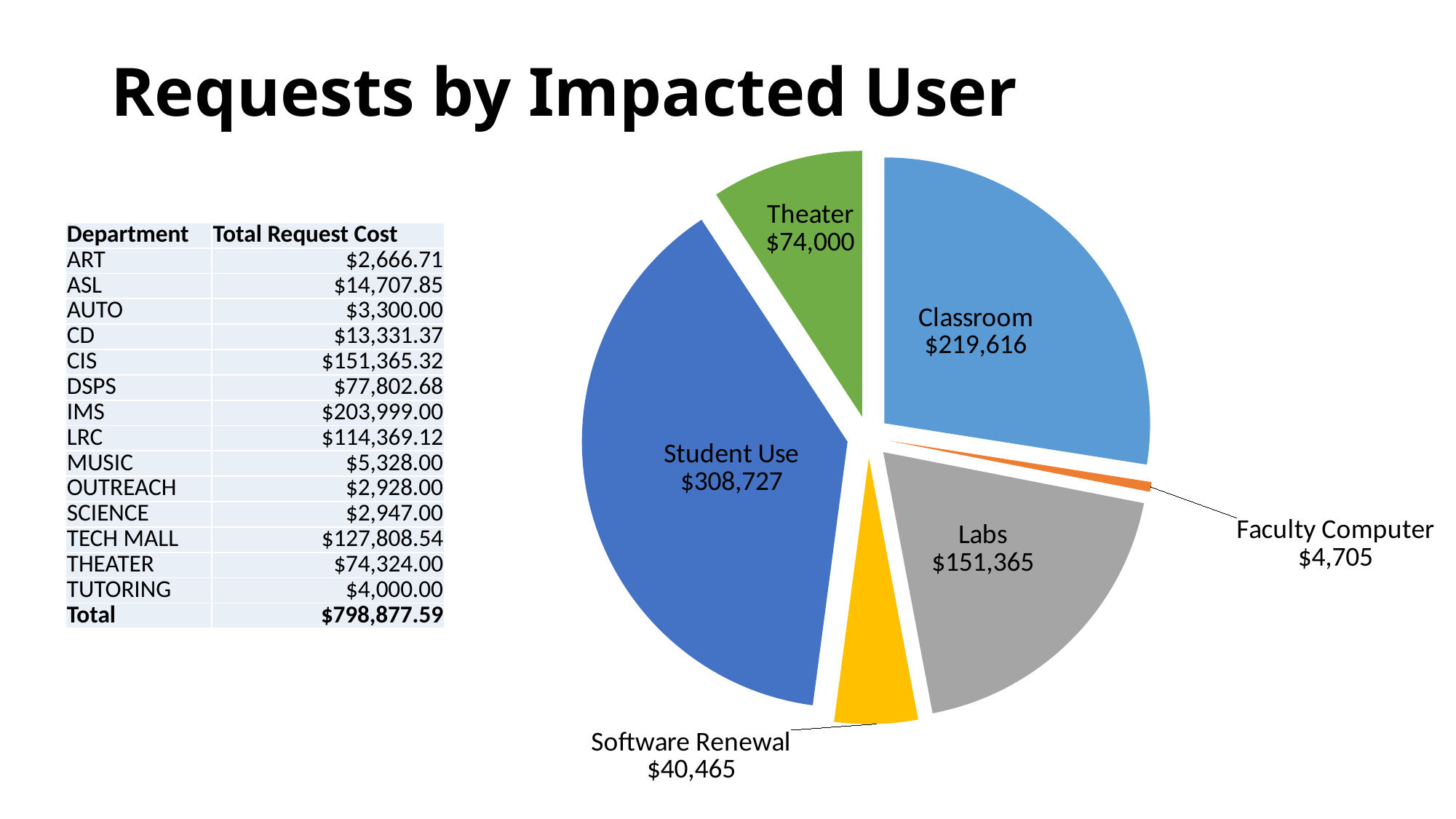
Which category has the smallest slice in the pie chart? Faculty Computer What is the value shown for Software Renewal in the pie chart? $40,465 What kind of chart is shown on the slide? Pie chart How many slices does the pie chart have? 6 What is the difference between the Theater value and the Software Renewal value in the pie chart? $33,535 What is the difference between the Classroom value and the Labs value in the pie chart? $68,251 What is the value shown for Classroom in the pie chart? $219,616 Which category has the largest slice in the pie chart? Student Use Which is larger in the pie chart, Labs or Theater? Labs What is the title of the slide containing the pie chart? Requests by Impacted User What is the value shown for Faculty Computer in the pie chart? $4,705 What is the value shown for Student Use in the pie chart? $308,727